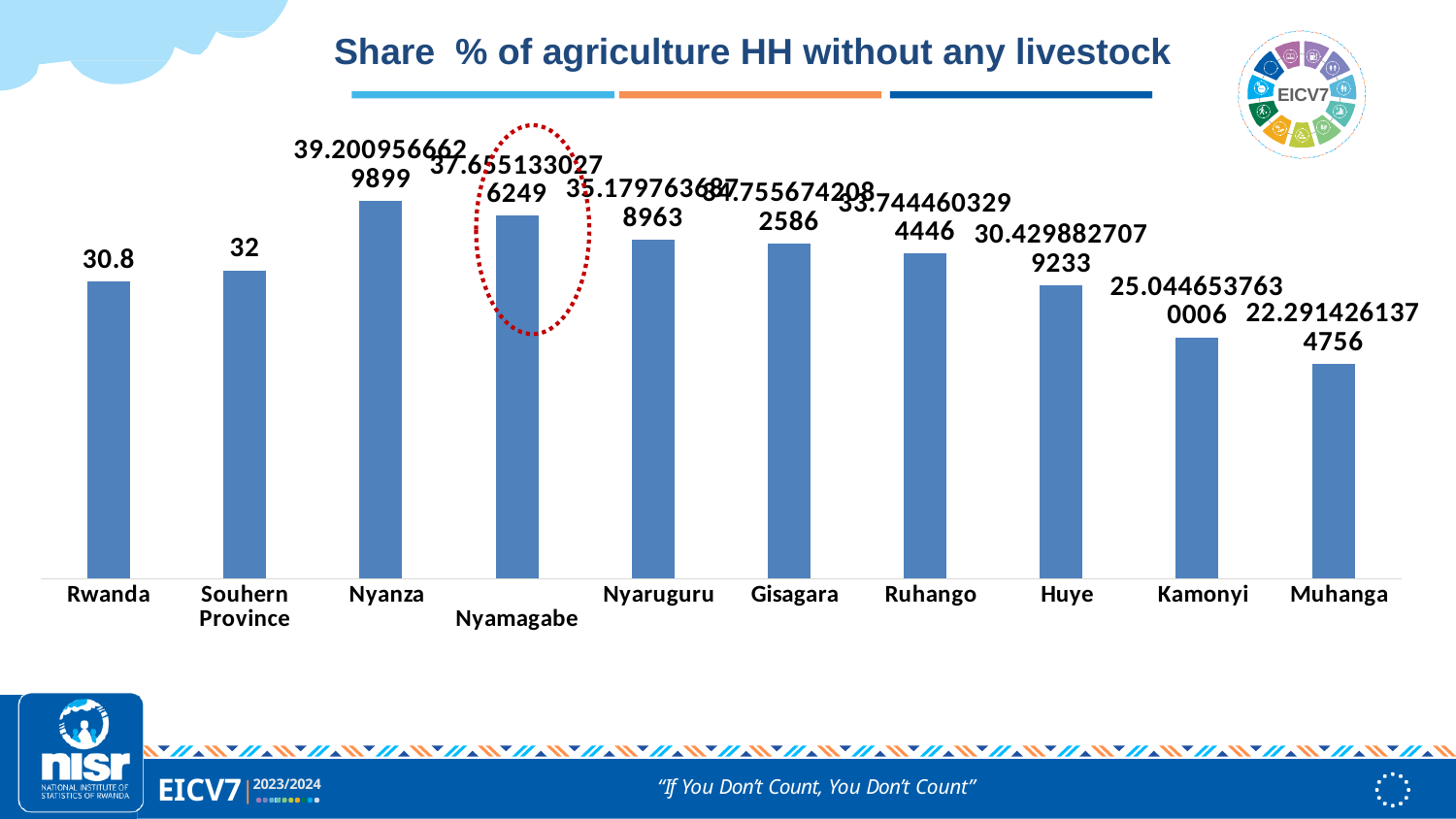
Do the values rise or fall from Nyanza to Muhanga along the x axis? fall Which category's bar is highlighted with a dotted red circle? Nyamagabe How many categories are shown on the x axis? 10 What is the value for Rwanda? 30.8 What is the title of the chart? Share % of agriculture HH without any livestock Which is larger, the value for Nyanza or the value for Muhanga? Nyanza Which category has the highest value? Nyanza What is the value for Souhern Province? 32 Which category has the lowest value? Muhanga What kind of chart is this? bar chart What is the difference between the values for Souhern Province and Rwanda? 1.2 Which is larger, the value for Huye or the value for Kamonyi? Huye